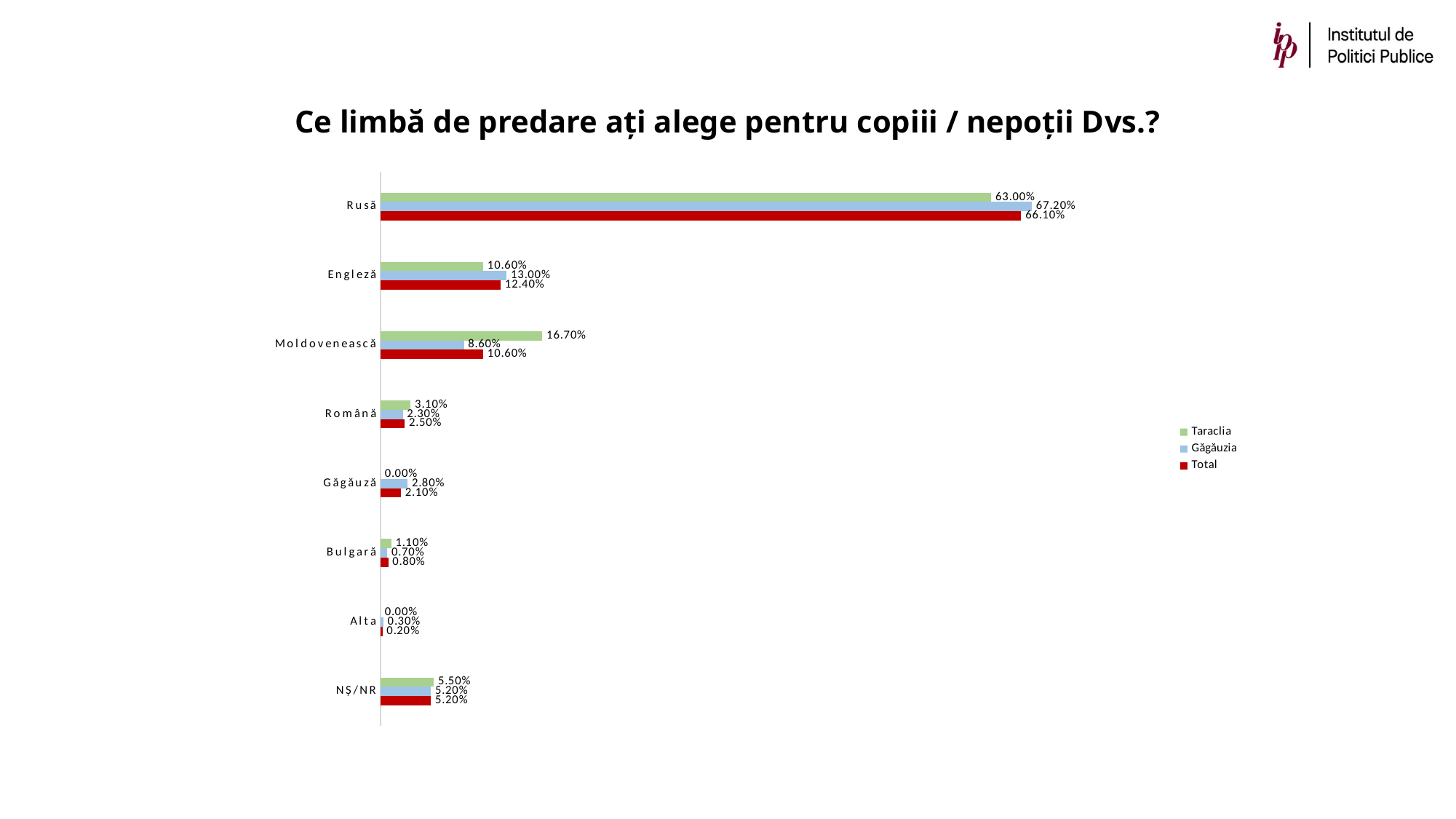
What is the Găgăuzia value for Engleză? 13.00% What is the Taraclia value for Găgăuză? 0.00% What is the Total value for Rusă? 66.10% Which category has the lowest Total value? Alta What is the difference between the Găgăuzia and Taraclia values for Rusă? 4.20% How many series does the legend list? 3 Which category has the highest Total value? Rusă Which is larger for Moldovenească: the Taraclia value or the Găgăuzia value? Taraclia Which series is shown in red in the legend? Total What is the Taraclia value for Moldovenească? 16.70% How many categories are shown on the chart? 8 What kind of chart is shown on the slide? Bar chart